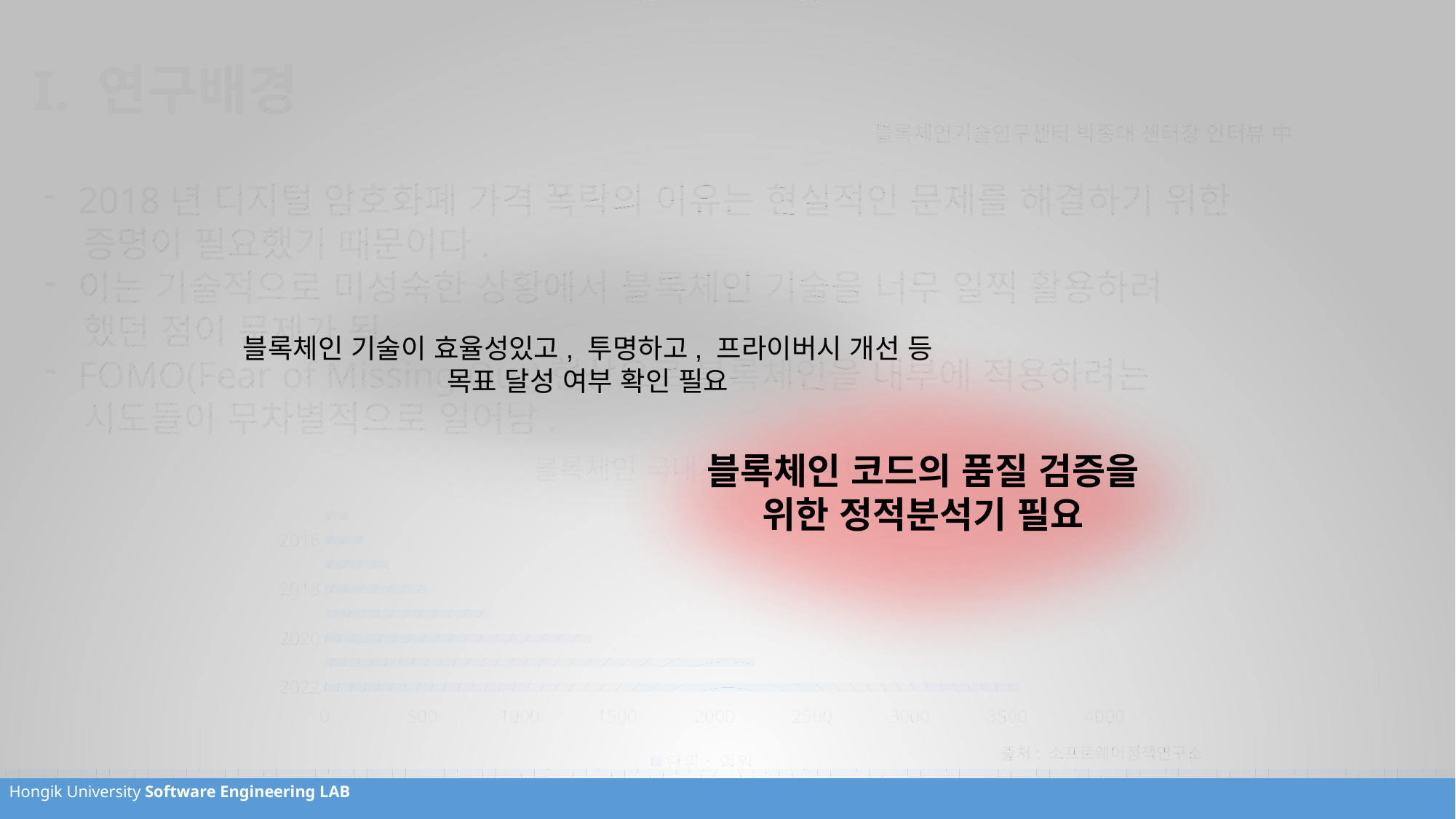
In the background bar chart, which labeled year has the longest bar? 2022 In the background bar chart, is the value for 2020 greater or less than 500? greater In the background bar chart, is the value for 2022 greater or less than 2500? greater In the background bar chart, do the bar lengths rise or fall going from 2016 down to 2022? rise What kind of chart is shown faintly in the background of the slide? bar chart In the background bar chart, which bar is longer, 2020 or 2022? 2022 In the background bar chart, is the value for 2016 greater or less than 500? less In the background bar chart, which labeled year has the shortest bar? 2016 How many year labels are shown on the vertical axis of the background bar chart? 4 What is the highest tick value shown on the horizontal axis of the background bar chart? 4000